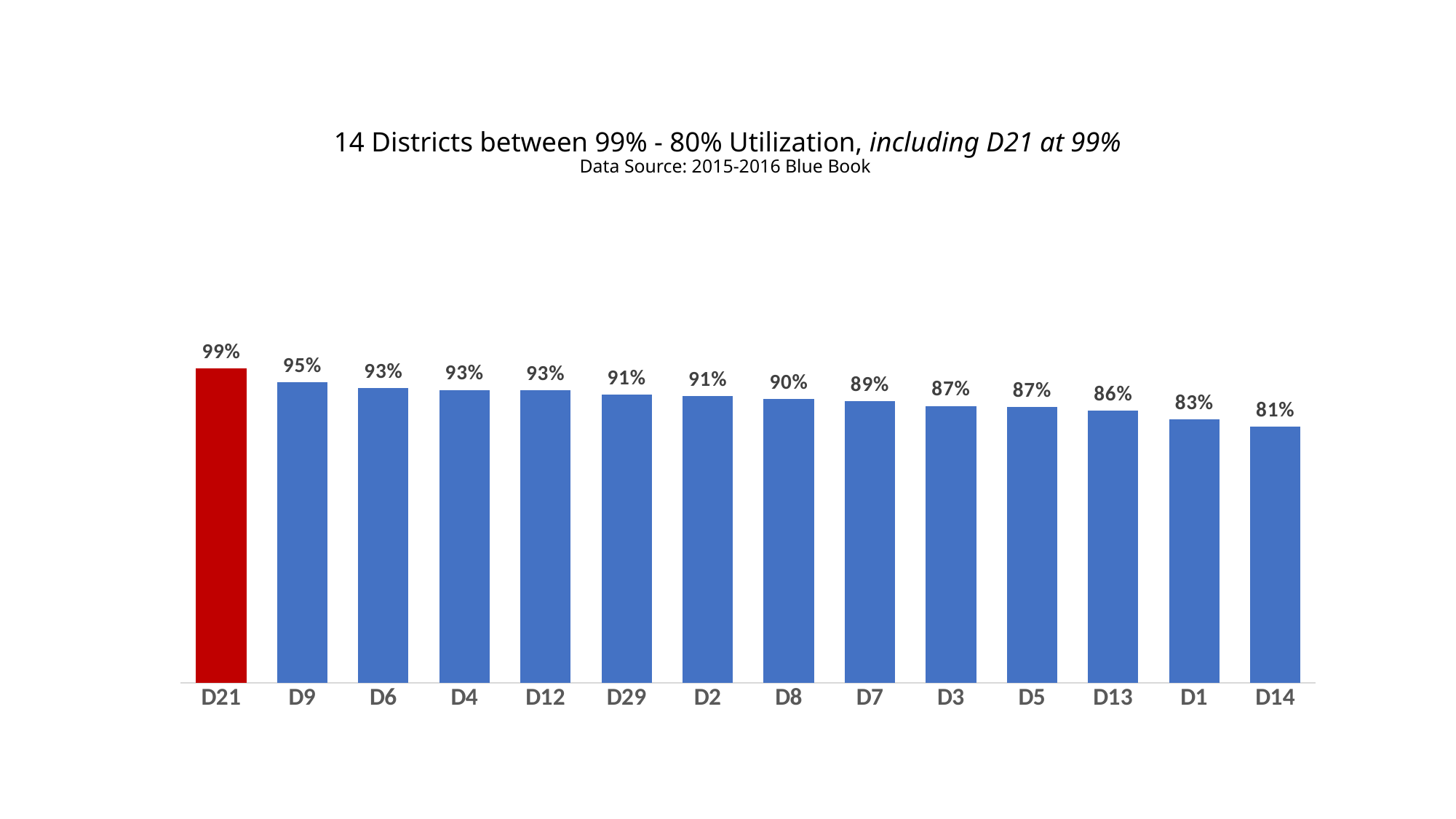
What kind of chart is shown on the slide? Bar chart What is the difference between the utilization of D9 and D1? 12% Which district has the highest utilization? D21 What is the utilization value for D29? 91% Which district has the lowest utilization? D14 How many districts are shown in the chart? 14 What is the utilization value for D21? 99% Do the values rise or fall from left to right along the x axis? Fall Which has a higher utilization, D8 or D3? D8 What is the difference between the utilization of D21 and D14? 18% Which district's bar is coloured red? D21 What is the utilization value for D13? 86%